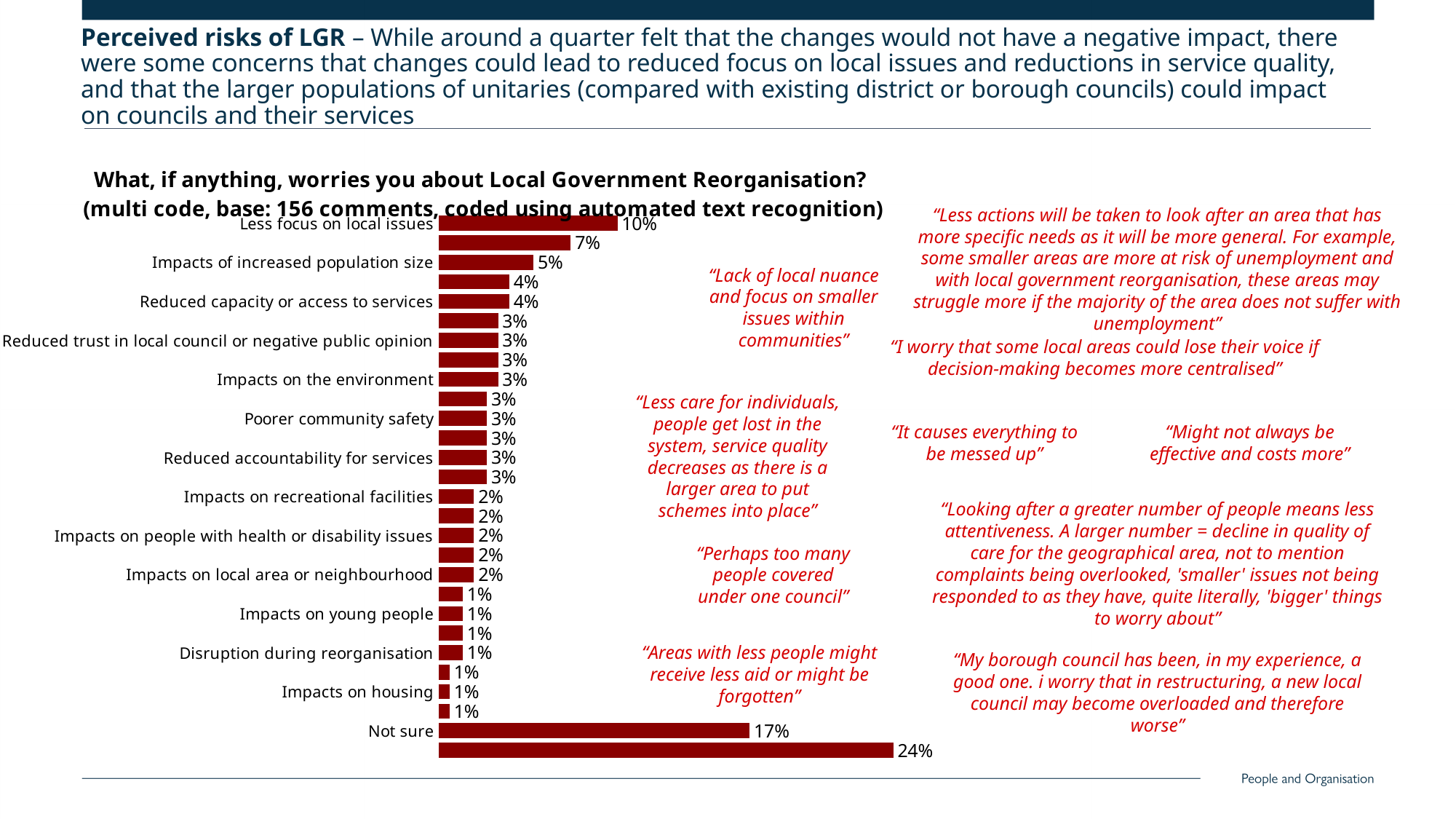
What percentage is shown for "Impacts on housing"? 1% Which is larger: "Not sure" or "Less focus on local issues"? Not sure Which is larger: "Impacts of increased population size" or "Impacts on recreational facilities"? Impacts of increased population size What is the value for "Impacts on the environment"? 3% What is the difference between the values for "Less focus on local issues" and "Impacts of increased population size"? 5% What is the value for "Impacts of increased population size"? 5% What kind of chart is shown on the slide? Bar chart What is the value for "Reduced capacity or access to services"? 4% What is the difference between the values for "Not sure" and "Less focus on local issues"? 7% What is the value for "Disruption during reorganisation"? 1% What percentage is shown for "Less focus on local issues"? 10% What percentage is shown for "Not sure"? 17%